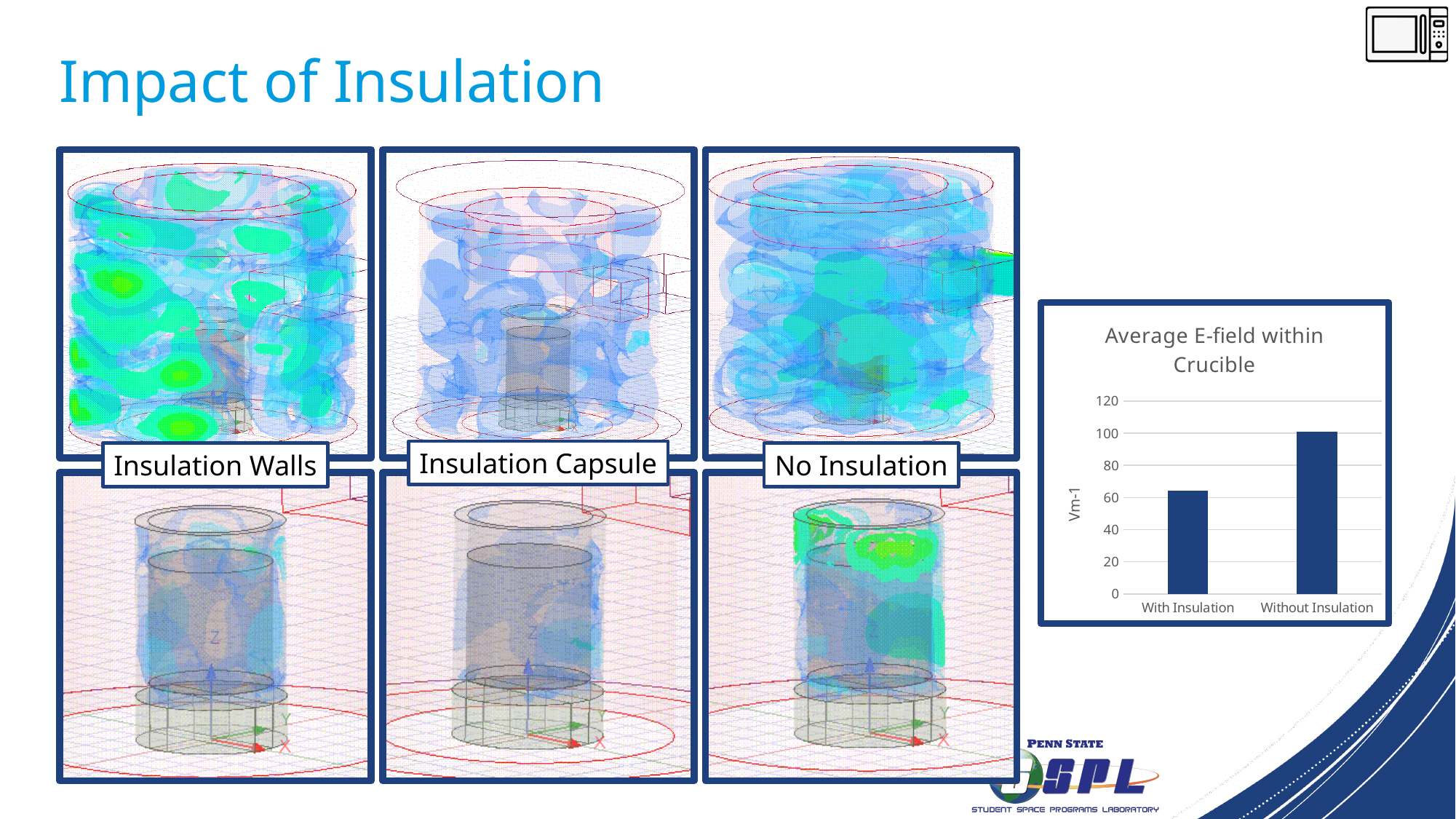
What kind of chart is the "Average E-field within Crucible" chart? bar chart What is the y-axis label of the "Average E-field within Crucible" chart? Vm-1 Which category has the highest value in the "Average E-field within Crucible" chart? Without Insulation What is the title of the bar chart on the slide? Average E-field within Crucible In the "Average E-field within Crucible" chart, is the value for Without Insulation greater or less than 80? greater In the "Average E-field within Crucible" chart, is the value for Without Insulation greater or less than 120? less What is the highest tick value on the y-axis of the "Average E-field within Crucible" chart? 120 In the "Average E-field within Crucible" chart, is the value for With Insulation greater or less than 80? less How many categories are shown on the "Average E-field within Crucible" chart? 2 In the "Average E-field within Crucible" chart, which is larger: the value for With Insulation or Without Insulation? Without Insulation Which category has the lowest value in the "Average E-field within Crucible" chart? With Insulation